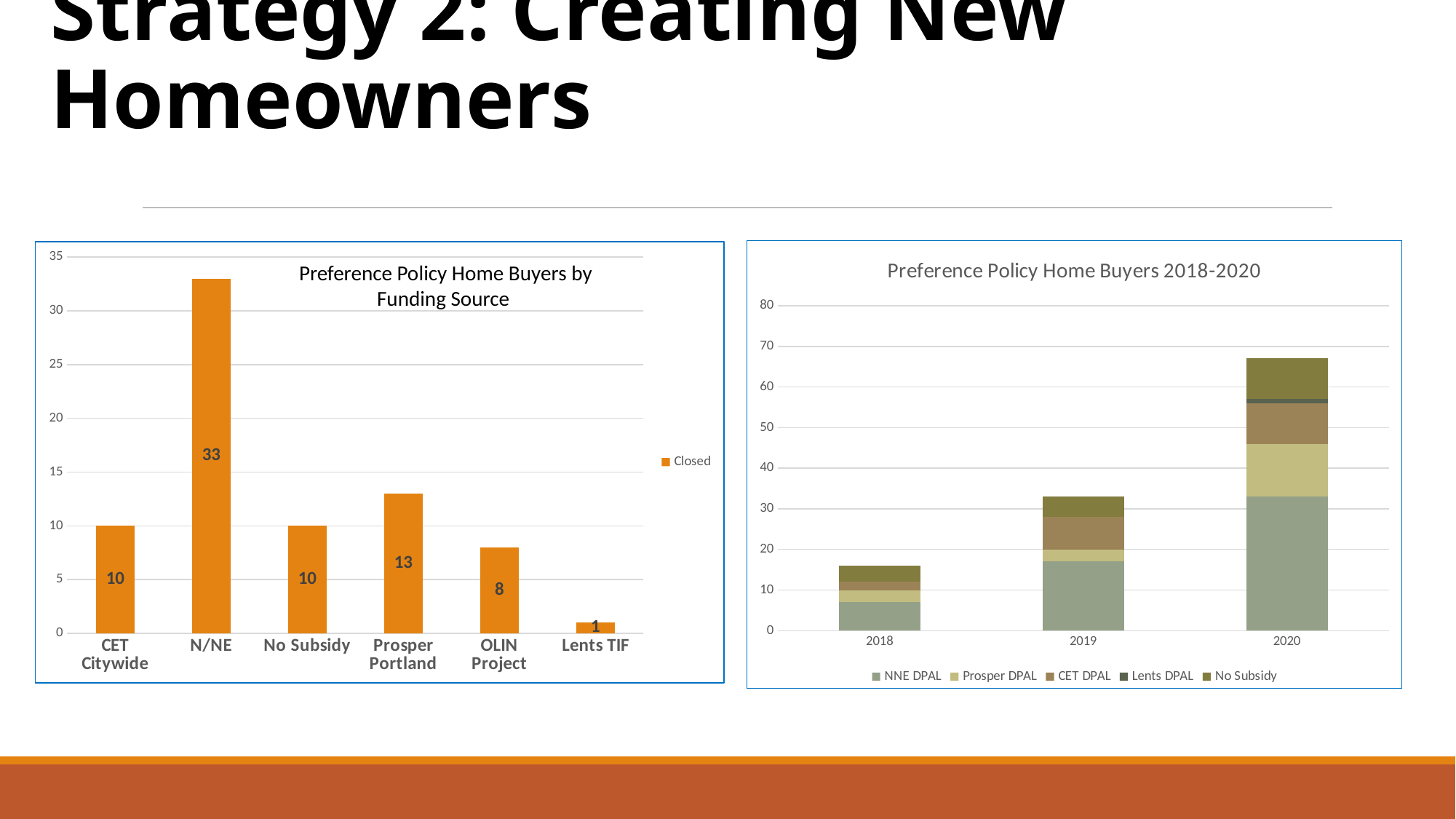
In the 'Preference Policy Home Buyers by Funding Source' chart, which funding source has the lowest value? Lents TIF In the 'Preference Policy Home Buyers by Funding Source' chart, what is the value for N/NE? 33 What kind of chart is 'Preference Policy Home Buyers 2018-2020'? Stacked bar chart How many funding source categories are shown in the 'Preference Policy Home Buyers by Funding Source' chart? 6 In the 'Preference Policy Home Buyers by Funding Source' chart, which is larger, Prosper Portland or CET Citywide? Prosper Portland How many series does the legend of the 'Preference Policy Home Buyers 2018-2020' chart list? 5 In the 'Preference Policy Home Buyers by Funding Source' chart, which funding source has the highest value? N/NE In the 'Preference Policy Home Buyers by Funding Source' chart, what is the value for Lents TIF? 1 In the 'Preference Policy Home Buyers by Funding Source' chart, what is the value for Prosper Portland? 13 In the 'Preference Policy Home Buyers by Funding Source' chart, what is the difference between N/NE and OLIN Project? 25 In the 'Preference Policy Home Buyers 2018-2020' chart, is the total for 2020 greater or less than 60? greater In the 'Preference Policy Home Buyers 2018-2020' chart, do the yearly totals rise or fall from 2018 to 2020? Rise